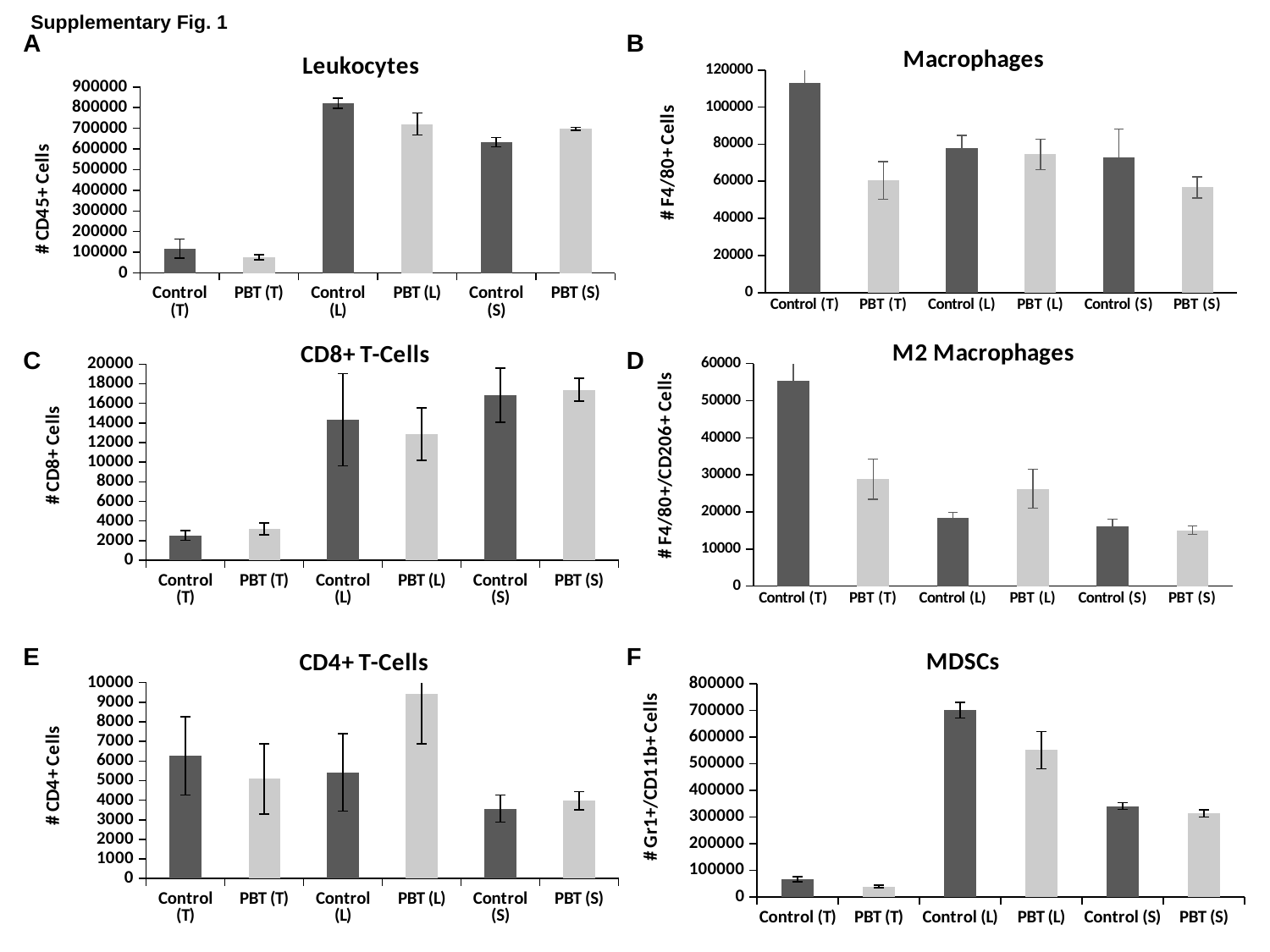
In the CD4+ T-Cells chart, which category has the highest value? PBT (L) How many categories are shown on the x axis of the MDSCs chart? 6 In the Macrophages chart, which category has the highest value? Control (T) In the M2 Macrophages chart, which is larger, the value for PBT (T) or the value for Control (L)? PBT (T) In the Leukocytes chart, which category has the lowest value? PBT (T) In the CD8+ T-Cells chart, which is larger, the value for Control (L) or the value for Control (T)? Control (L) In the Leukocytes chart, which category has the highest value? Control (L) In the Leukocytes chart, is the value for Control (S) greater or less than 500000? greater In the MDSCs chart, which category has the lowest value? PBT (T) What is the y-axis label of the Macrophages chart? # F4/80+ Cells In the Macrophages chart, is the value for Control (T) greater or less than 100000? greater